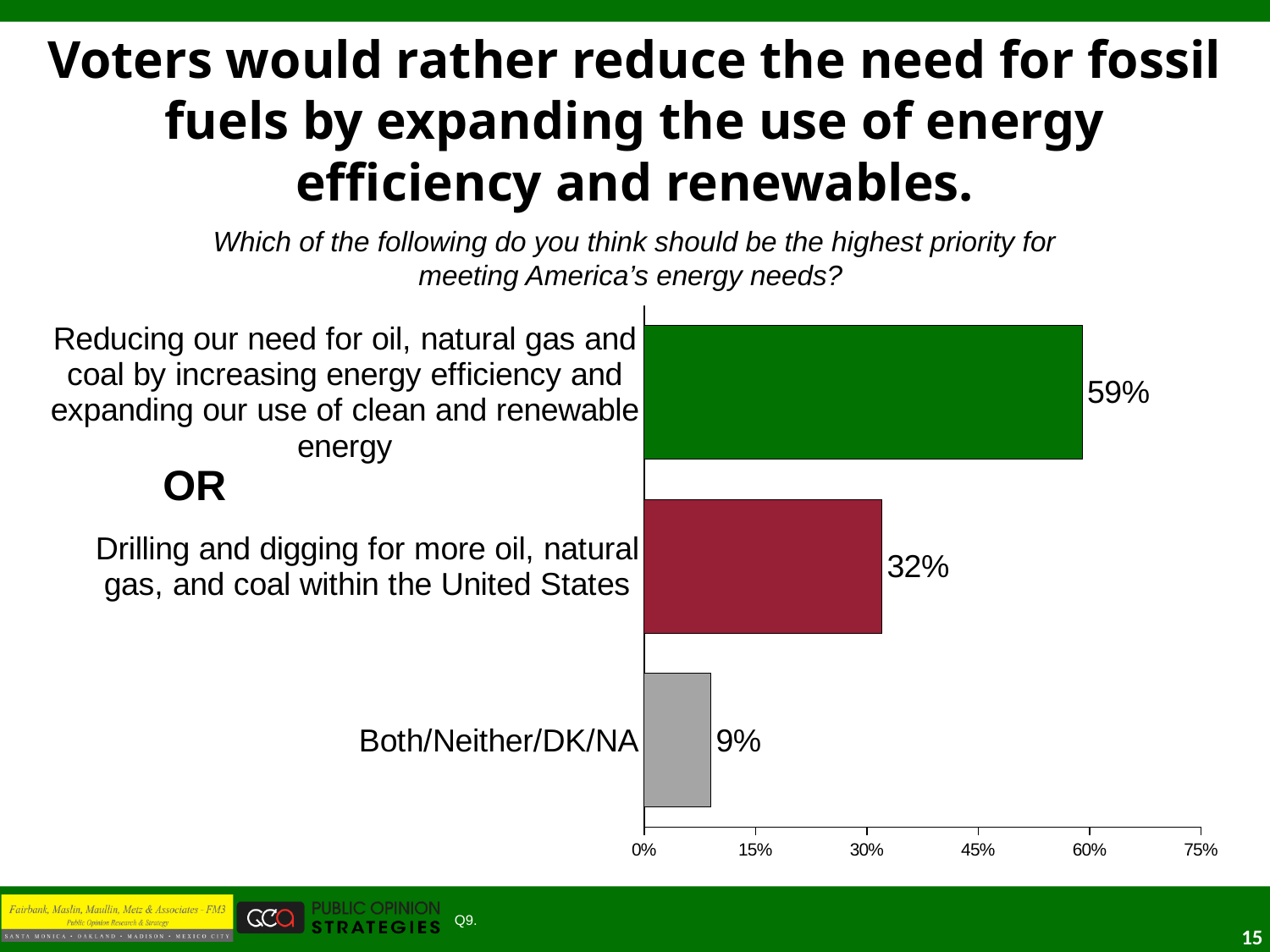
Which received a larger share: drilling and digging for more oil, natural gas, and coal, or Both/Neither/DK/NA? Drilling and digging for more oil, natural gas, and coal within the United States What is the difference in percentage points between the energy efficiency/renewables option and the drilling option? 27 What percentage of voters chose drilling and digging for more oil, natural gas, and coal within the United States? 32% How many response categories are shown in the chart? 3 Is the value for the drilling and digging option greater or less than 30%? greater What colour is the bar for the drilling and digging option? Dark red Which response option received the lowest percentage? Both/Neither/DK/NA What percentage of respondents answered Both/Neither/DK/NA? 9% Which response option received the highest percentage? Reducing our need for oil, natural gas and coal by increasing energy efficiency and expanding our use of clean and renewable energy What percentage of voters chose reducing the need for oil, natural gas and coal by increasing energy efficiency and expanding clean and renewable energy? 59% What type of chart is shown on the slide? Bar chart What is the difference in percentage points between the drilling option and Both/Neither/DK/NA? 23